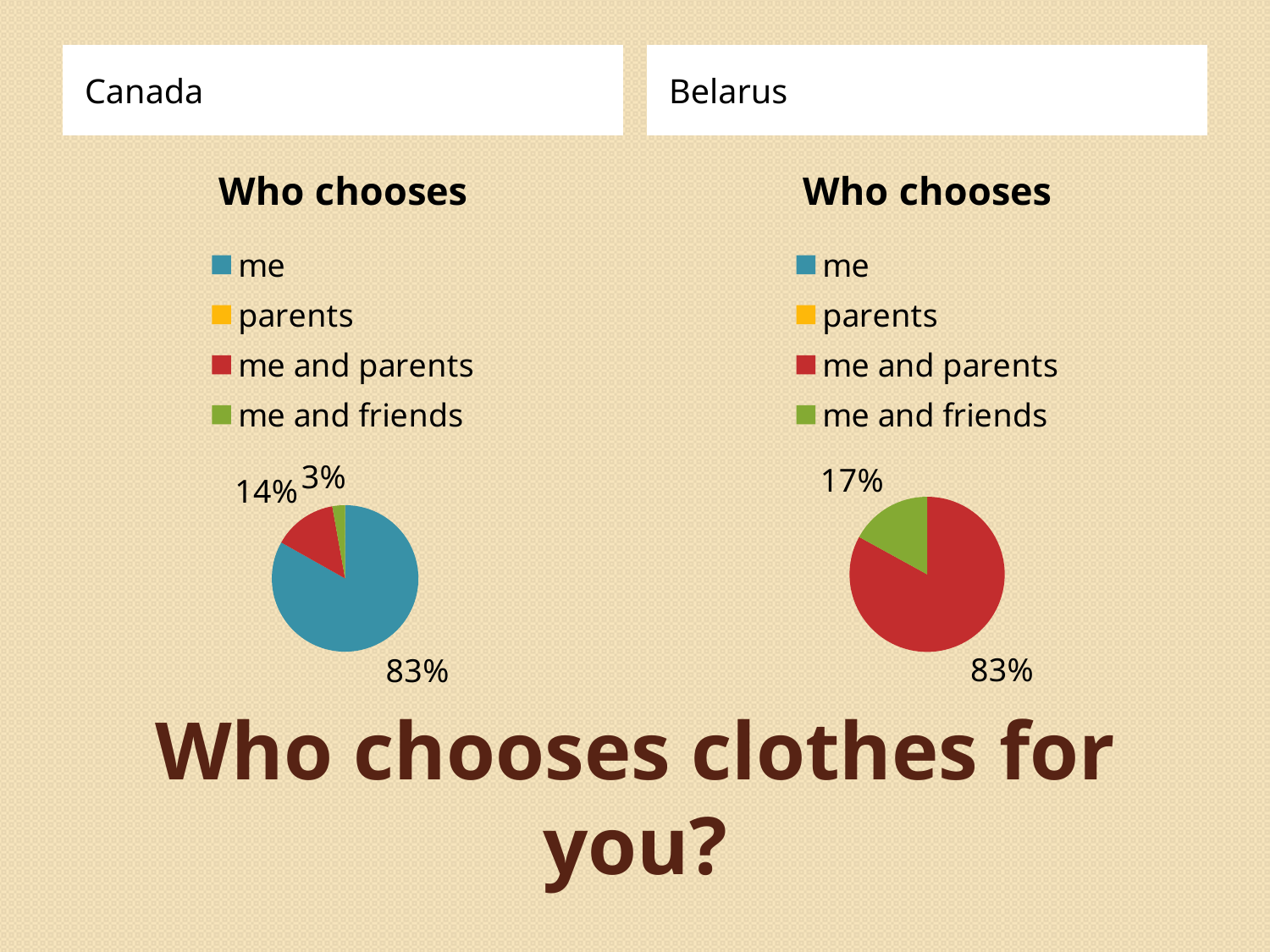
In the Canada chart, what share of respondents answered "me and parents"? 14% In the Belarus chart, which category has the largest slice? me and parents In the Belarus chart, what share of respondents answered "me and friends"? 17% In the Canada chart, what is the difference between the "me" share and the "me and parents" share? 69% What type of chart is used for the Canada data? Pie chart In the Canada chart, which category has the smallest slice? me and friends In the Belarus chart, what is the difference between the "me and parents" share and the "me and friends" share? 66% How many entries does the legend of the Belarus chart list? 4 In the Canada chart, which category has the largest slice? me In the Belarus chart, what share of respondents answered "me and parents"? 83% In the Canada chart, what share of respondents answered "me"? 83% In the Canada chart, what share of respondents answered "me and friends"? 3%